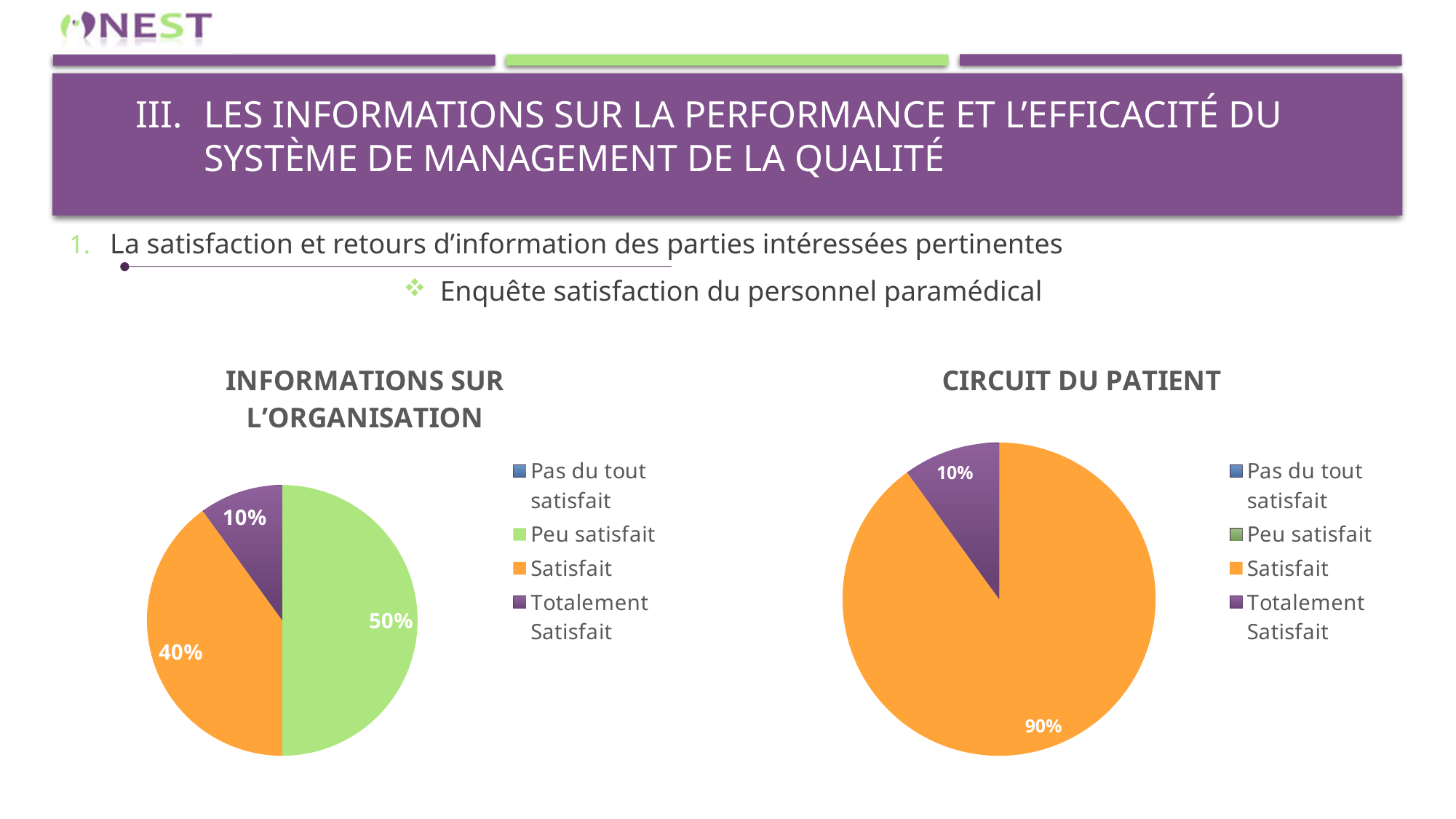
In the 'CIRCUIT DU PATIENT' chart, what share is labelled for 'Totalement Satisfait'? 10% How many entries does the legend of the 'INFORMATIONS SUR L'ORGANISATION' chart list? 4 In the 'INFORMATIONS SUR L'ORGANISATION' chart, what share is labelled for 'Satisfait'? 40% In the 'CIRCUIT DU PATIENT' chart, which category has the largest slice? Satisfait In the 'INFORMATIONS SUR L'ORGANISATION' chart, what share is labelled for 'Totalement Satisfait'? 10% In the 'INFORMATIONS SUR L'ORGANISATION' chart, what is the difference between the 'Peu satisfait' and 'Satisfait' shares? 10% In the 'CIRCUIT DU PATIENT' chart, what share is labelled for 'Satisfait'? 90% What type of chart is the 'CIRCUIT DU PATIENT' chart? Pie chart In the 'CIRCUIT DU PATIENT' chart, what is the difference between the 'Satisfait' and 'Totalement Satisfait' shares? 80% In the 'INFORMATIONS SUR L'ORGANISATION' chart, which category has the largest slice? Peu satisfait In the 'INFORMATIONS SUR L'ORGANISATION' chart, which is larger: 'Satisfait' or 'Totalement Satisfait'? Satisfait In the 'INFORMATIONS SUR L'ORGANISATION' chart, what share is labelled for 'Peu satisfait'? 50%